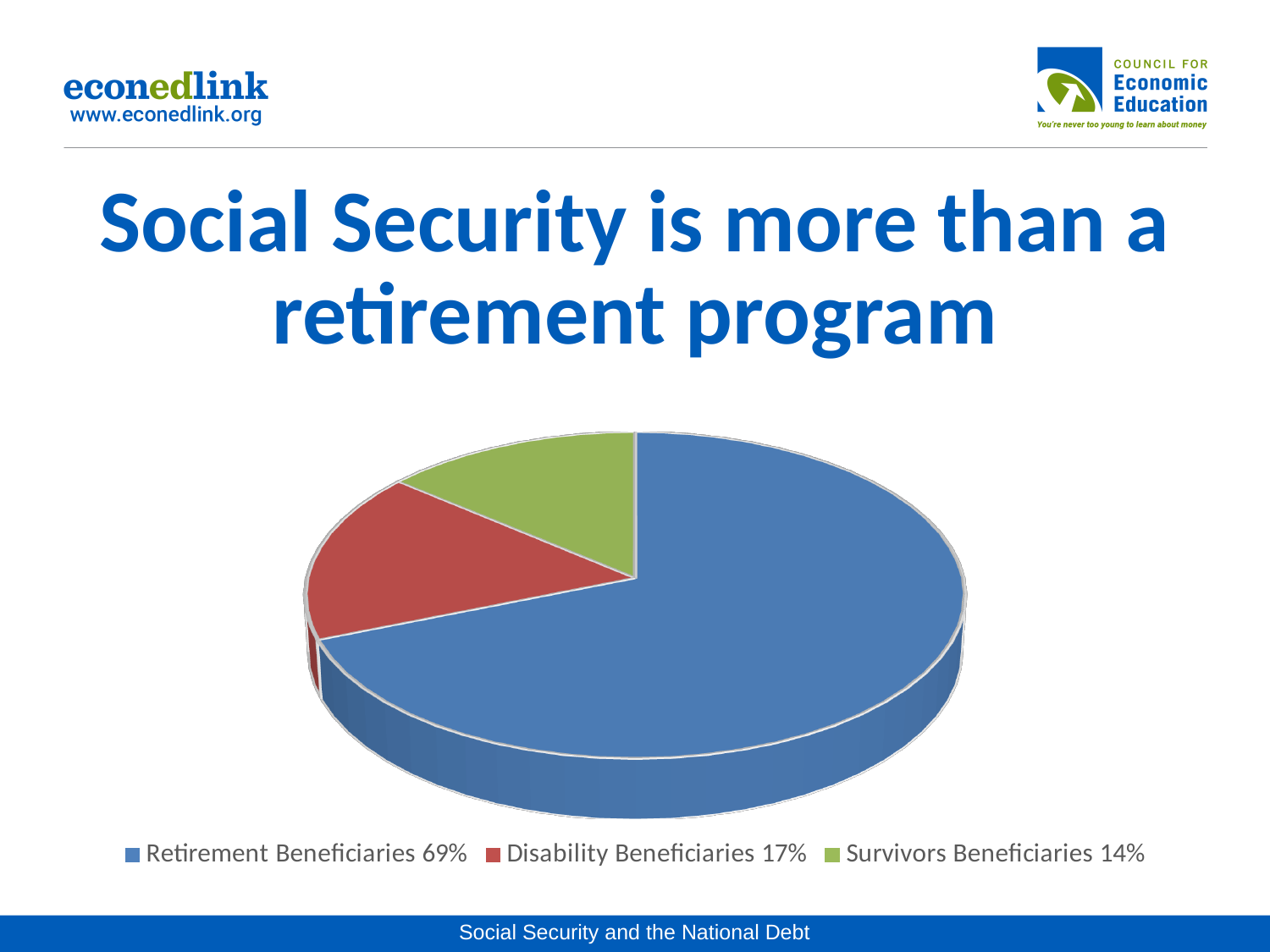
What colour is the Survivors Beneficiaries slice? Green What share of the pie is Survivors Beneficiaries? 14% What is the title shown above the pie chart? Social Security is more than a retirement program What share of the pie is Retirement Beneficiaries? 69% What share of the pie is Disability Beneficiaries? 17% What kind of chart is shown on the slide? Pie chart How many categories does the pie chart show? 3 What is the difference in percentage points between Disability Beneficiaries and Survivors Beneficiaries? 3 Which category has the largest slice of the pie? Retirement Beneficiaries Which is larger, the share for Disability Beneficiaries or the share for Survivors Beneficiaries? Disability Beneficiaries What is the difference in percentage points between Retirement Beneficiaries and Disability Beneficiaries? 52 Which category has the smallest slice of the pie? Survivors Beneficiaries